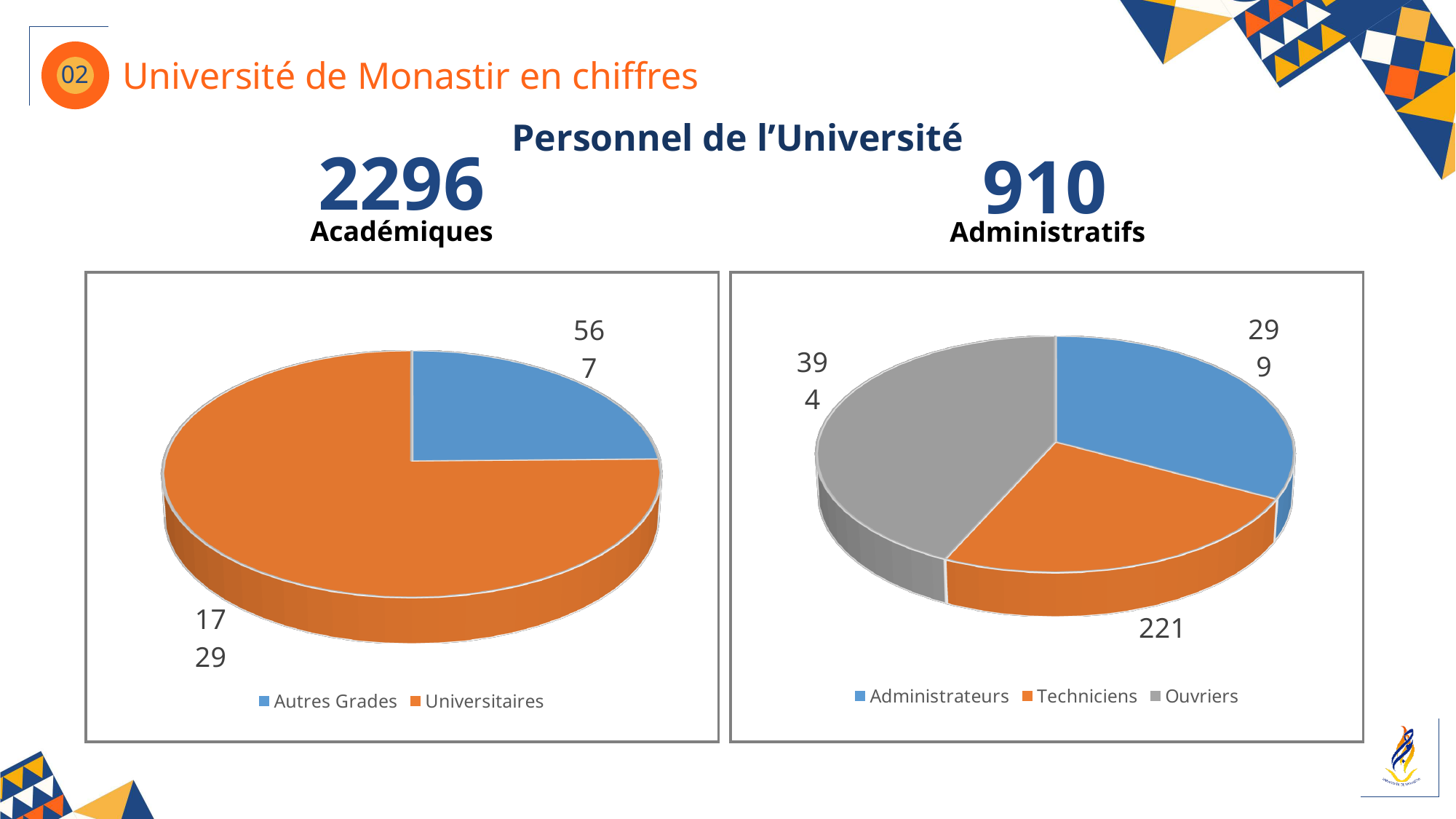
In the Académiques chart on the left, what is the value for Universitaires? 1729 In the Administratifs chart on the right, which category has the largest slice? Ouvriers What kind of chart is the Académiques chart on the left? pie chart In the Académiques chart on the left, which category has the largest slice? Universitaires How many slices does the Académiques chart on the left have? 2 In the Académiques chart on the left, what is the difference between Universitaires and Autres Grades? 1162 In the Académiques chart on the left, what is the value for Autres Grades? 567 In the Administratifs chart on the right, which is larger, Administrateurs or Techniciens? Administrateurs In the Administratifs chart on the right, which colour represents Ouvriers? grey In the Administratifs chart on the right, which category has the smallest slice? Techniciens In the Administratifs chart on the right, what is the value for Techniciens? 221 How many series does the legend of the Administratifs chart on the right list? 3